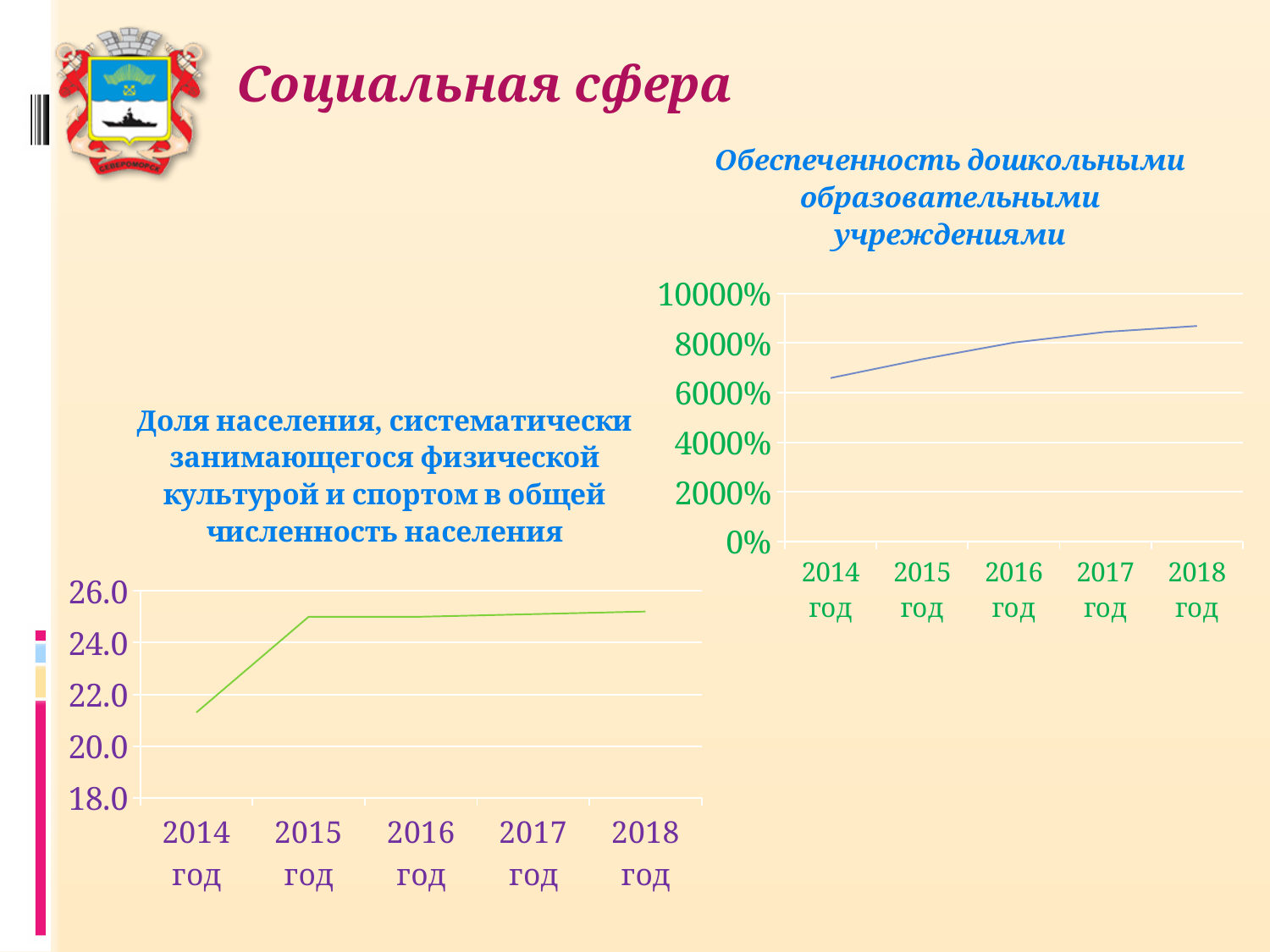
In the chart titled "Обеспеченность дошкольными образовательными учреждениями", is the value for 2018 год greater or less than 8000%? greater What kind of chart is the chart titled "Обеспеченность дошкольными образовательными учреждениями"? line chart In the chart titled "Доля населения, систематически занимающегося физической культурой и спортом в общей численность населения", which year has the lowest value? 2014 год How many years are plotted on the x axis of the chart titled "Обеспеченность дошкольными образовательными учреждениями"? 5 In the chart titled "Обеспеченность дошкольными образовательными учреждениями", which year has the lowest value? 2014 год In the chart titled "Обеспеченность дошкольными образовательными учреждениями", is the value for 2014 год greater or less than 6000%? greater How many years are plotted on the x axis of the chart titled "Доля населения, систематически занимающегося физической культурой и спортом в общей численность населения"? 5 What kind of chart is the chart titled "Доля населения, систематически занимающегося физической культурой и спортом в общей численность населения"? line chart In the chart titled "Доля населения, систематически занимающегося физической культурой и спортом в общей численность населения", do the values rise or fall from 2014 год to 2018 год? rise In the chart titled "Обеспеченность дошкольными образовательными учреждениями", do the values rise or fall from 2014 год to 2018 год? rise In the chart titled "Доля населения, систематически занимающегося физической культурой и спортом в общей численность населения", which is larger, the value for 2014 год or the value for 2018 год? 2018 год In the chart titled "Доля населения, систематически занимающегося физической культурой и спортом в общей численность населения", is the value for 2014 год greater or less than 22.0? less